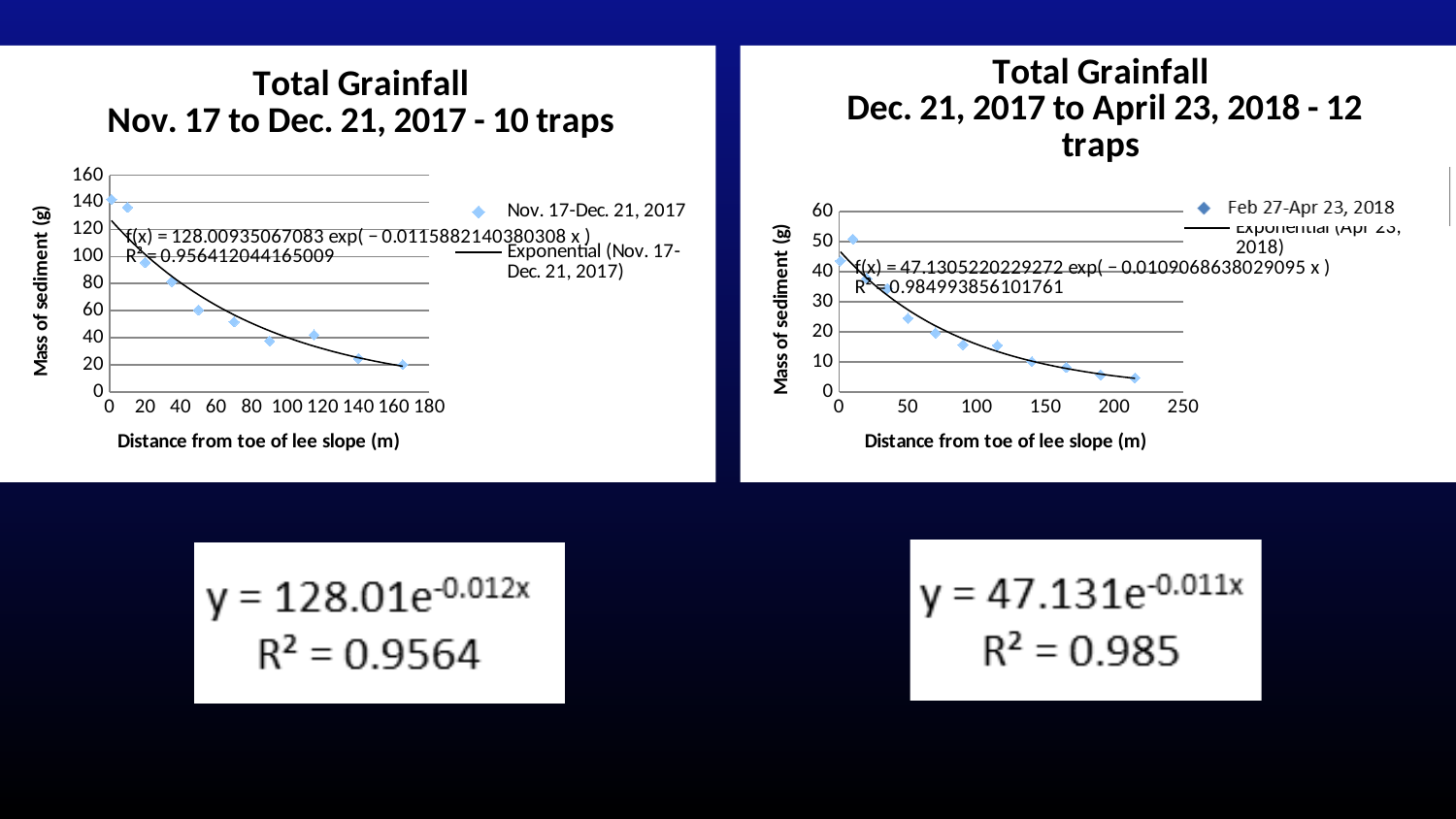
In the right chart (Dec. 21, 2017 to April 23, 2018), do the mass of sediment values generally rise or fall as distance from the toe of the lee slope increases? fall In the right chart (Dec. 21, 2017 to April 23, 2018), is the mass of sediment at a distance of about 10 m greater or less than 40 g? greater In the left chart (Nov. 17 to Dec. 21, 2017), how many data points are plotted? 10 How many entries does the legend of the right chart (Dec. 21, 2017 to April 23, 2018) list? 2 In the left chart (Nov. 17 to Dec. 21, 2017), is the mass of sediment at a distance of 0 m greater or less than 120 g? greater What type of chart is the left chart, 'Total Grainfall Nov. 17 to Dec. 21, 2017 - 10 traps'? Scatter chart In the right chart (Dec. 21, 2017 to April 23, 2018), is the mass of sediment at the farthest trap (about 215 m) greater or less than 10 g? less In the left chart (Nov. 17 to Dec. 21, 2017), which is larger: the mass of sediment at about 20 m or at about 140 m? about 20 m What is the y-axis label of the left chart (Nov. 17 to Dec. 21, 2017)? Mass of sediment (g) What R² value is printed on the right chart (Dec. 21, 2017 to April 23, 2018) next to the trendline equation? 0.984993856101761